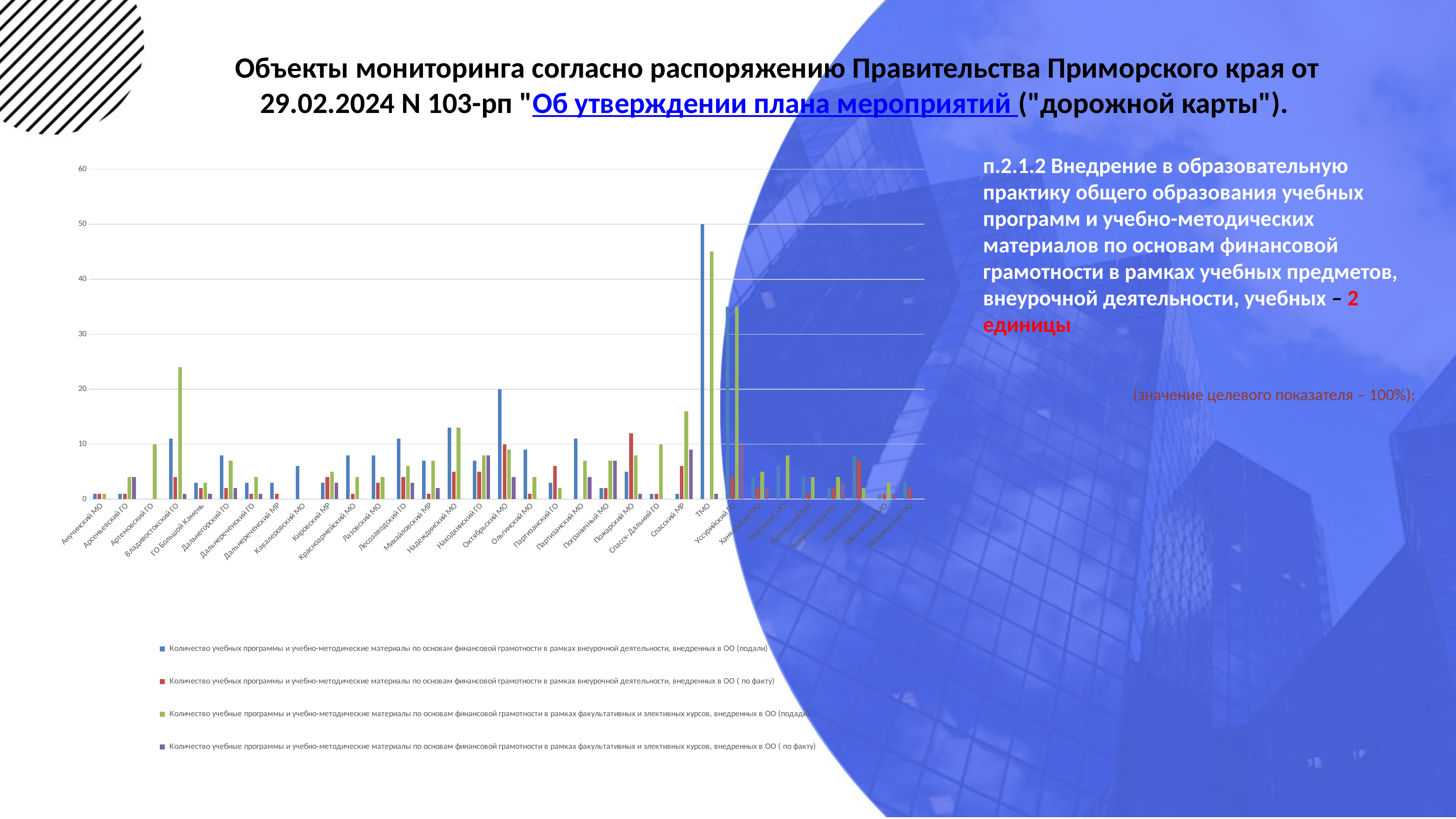
Which is larger: the green bar for Владивостокский ГО or the green bar for Артемовский ГО? Владивостокский ГО How many series does the chart legend list? 4 What is the value of the blue bar for ТМО? 50 Is the green bar for Владивостокский ГО greater or less than 20? greater Is the blue bar for Уссурийский ГО greater or less than 30? greater What is the value of the blue bar for Октябрьский МО? 20 What is the highest value shown on the chart's vertical axis? 60 What kind of chart is shown on the slide? bar chart Is the green bar for ТМО greater or less than 40? greater Which category has the tallest blue bar in the chart? ТМО Which is larger: the blue bar for ТМО or the blue bar for Уссурийский ГО? ТМО What is the value of the green bar for Артемовский ГО? 10